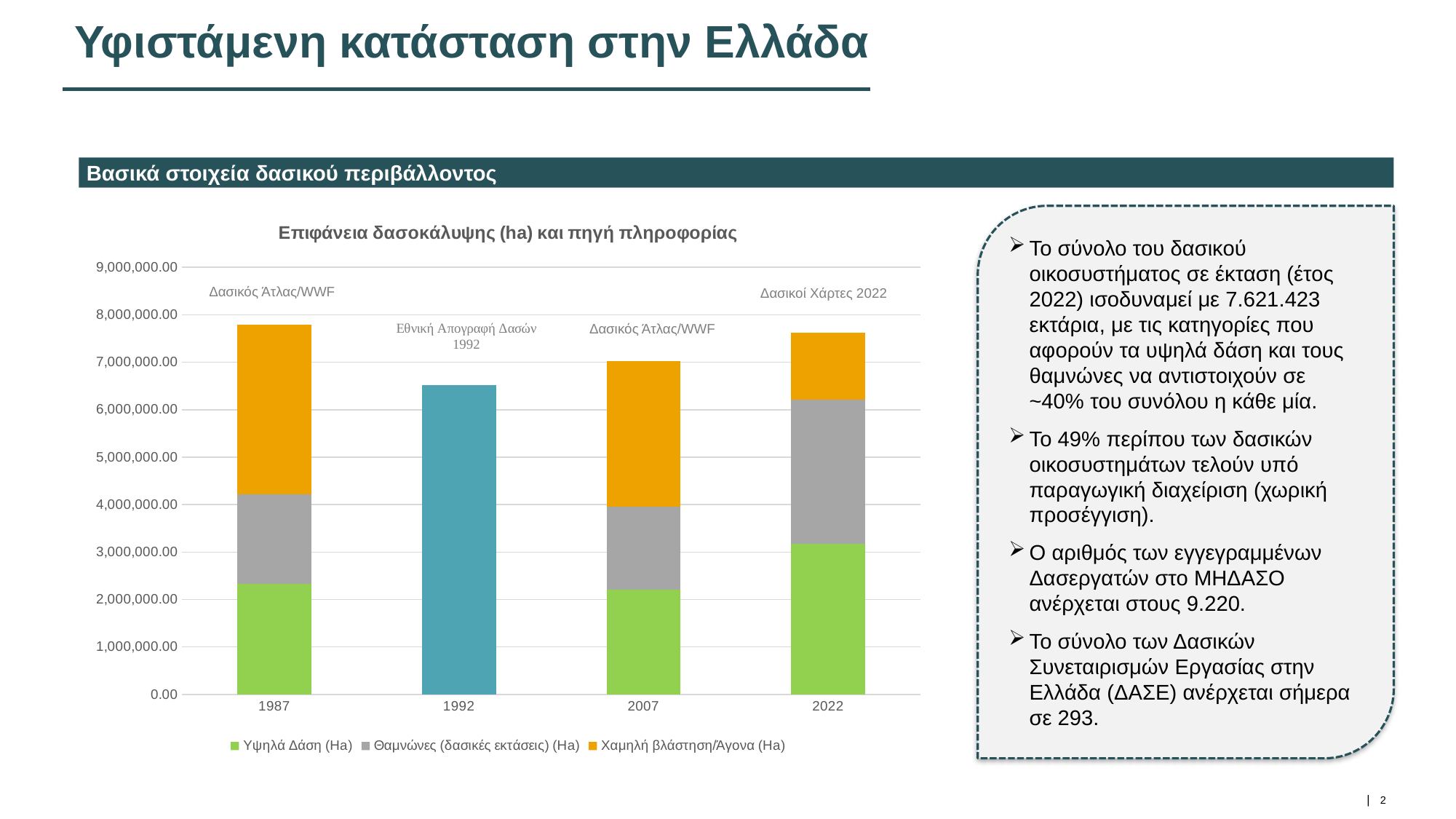
Is the Υψηλά Δάση (Ha) segment for 1987 greater or less than 2,000,000.00? greater Which year has the lowest total bar in the chart? 1992 What is the title of the chart? Επιφάνεια δασοκάλυψης (ha) και πηγή πληροφορίας Which year has the larger Υψηλά Δάση (Ha) segment, 1987 or 2022? 2022 How many years (categories) are shown on the x axis of the chart? 4 What source label is written above the 1992 bar? Εθνική Απογραφή Δασών 1992 Is the total bar for 1987 greater or less than 7,000,000.00? greater What kind of chart is shown on the slide? bar chart Is the total bar for 1992 greater or less than 7,000,000.00? less How many series does the chart legend list? 3